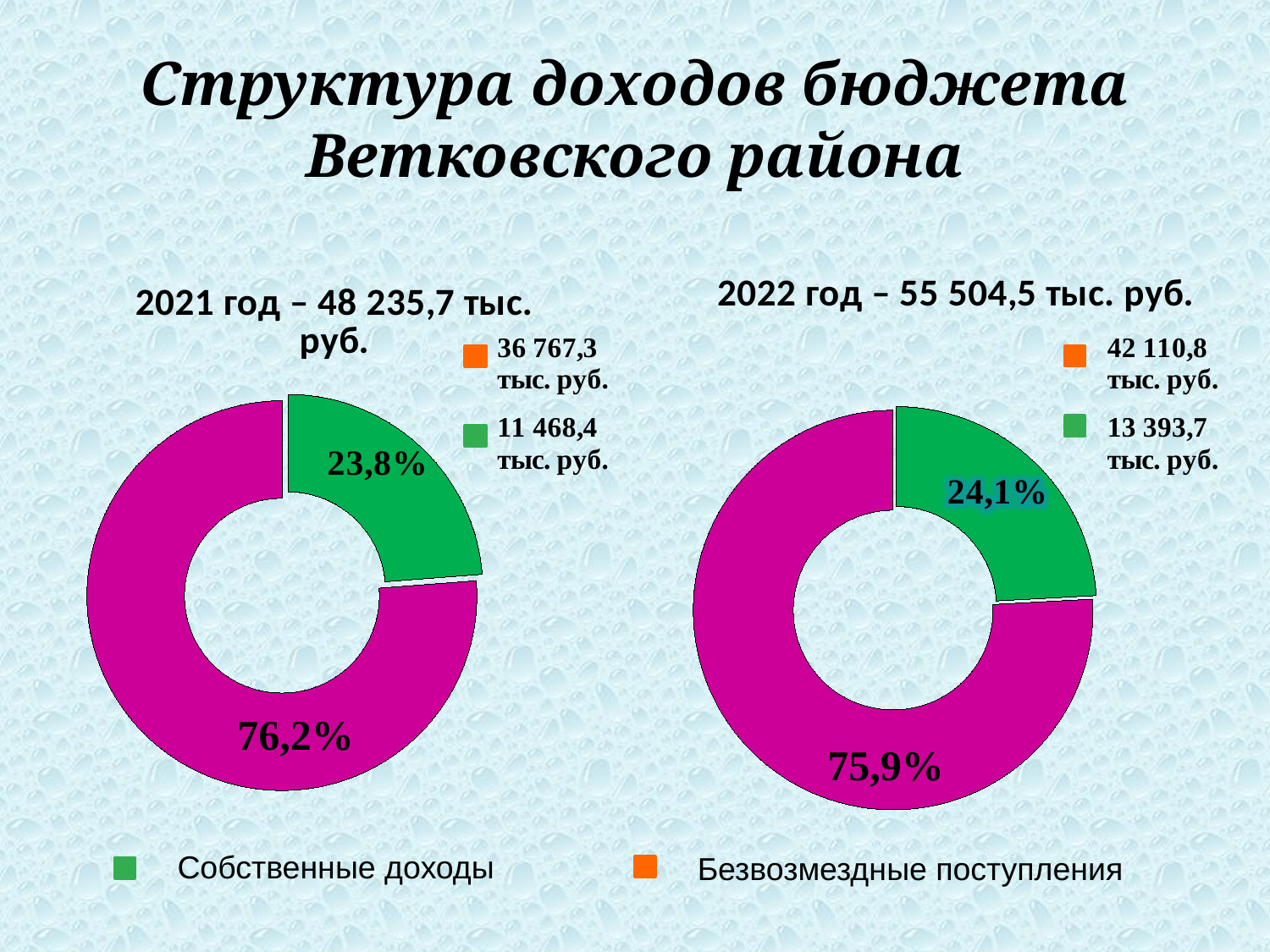
In the 2022 chart, what percentage is labelled on the larger magenta slice? 75,9% How many slices does each doughnut chart on the slide contain? 2 According to the 2021 chart legend, what is the value of Собственные доходы (green) in 2021? 11 468,4 тыс. руб. What is the total budget revenue stated in the title of the 2022 chart? 55 504,5 тыс. руб. What type of chart is used on the slide for the 2021 and 2022 budget structure? Doughnut (pie) chart Which category does the green colour represent in the legend at the bottom of the slide? Собственные доходы In the 2021 chart, what percentage is labelled on the larger magenta slice? 76,2% In the 2021 chart, what share of the budget revenue is shown for the green slice (Собственные доходы)? 23,8% In the 2021 chart, what is the difference in percentage points between the larger slice (76,2%) and the smaller slice (23,8%)? 52,4 In the 2022 chart, what share of the budget revenue is shown for the green slice (Собственные доходы)? 24,1% According to the 2022 chart legend, what is the value of Безвозмездные поступления (orange) in 2022? 42 110,8 тыс. руб. Which slice is larger in the 2022 chart: the one labelled 24,1% or the one labelled 75,9%? 75,9%